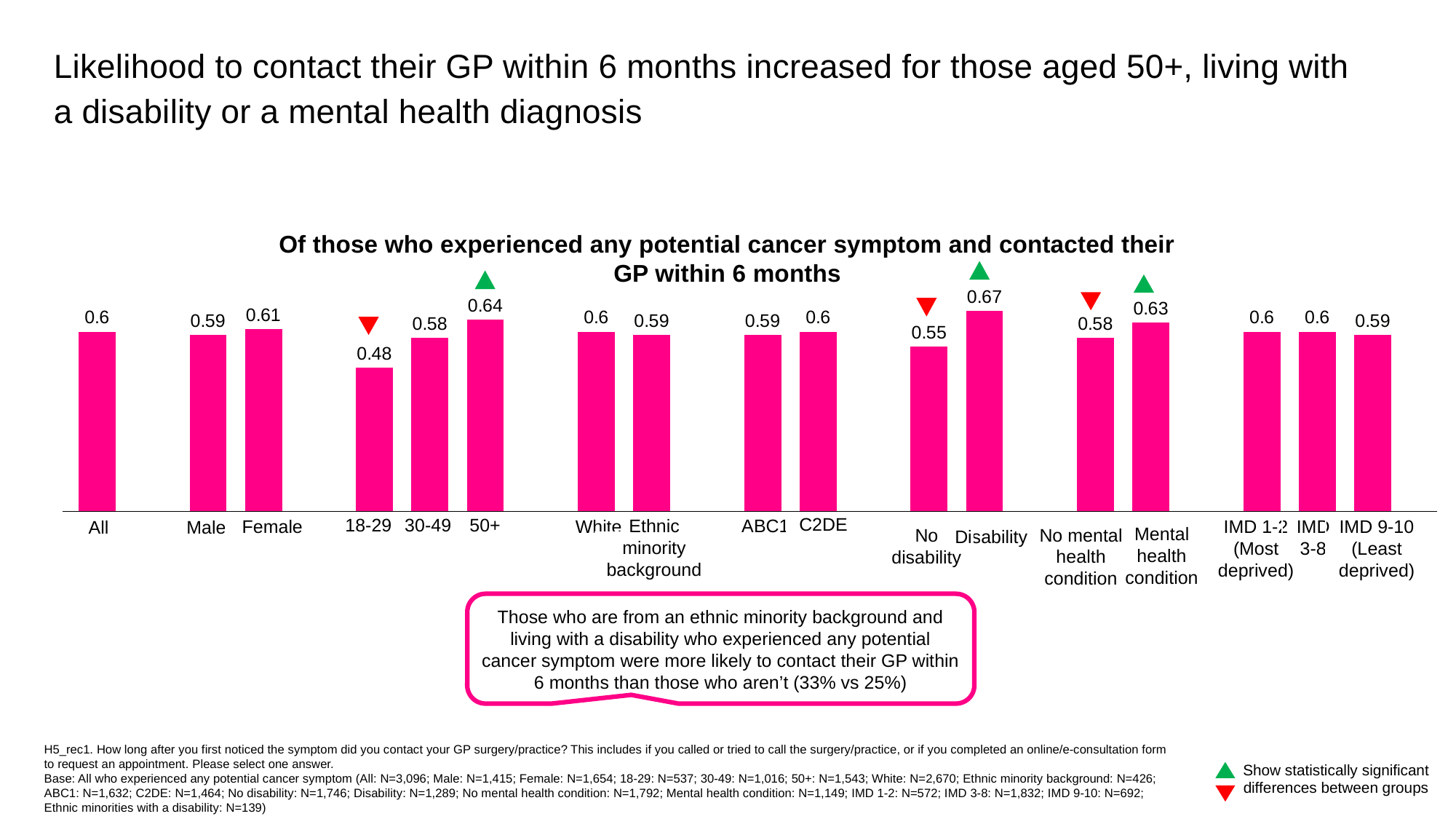
What is the value for the Disability group? 0.67 What is the value for the Mental health condition group? 0.63 What is the value for the 18-29 age group? 0.48 What is the difference between the Disability and No disability values? 0.12 Which category has the highest value? Disability What type of chart is shown on the slide? Bar chart Which is larger, the value for Mental health condition or the value for No mental health condition? Mental health condition How many bars are plotted in the chart? 17 What is the value for the 50+ age group? 0.64 Which is larger, the value for Female or the value for Male? Female Which category has the lowest value? 18-29 What is the difference between the 50+ and 18-29 values? 0.16